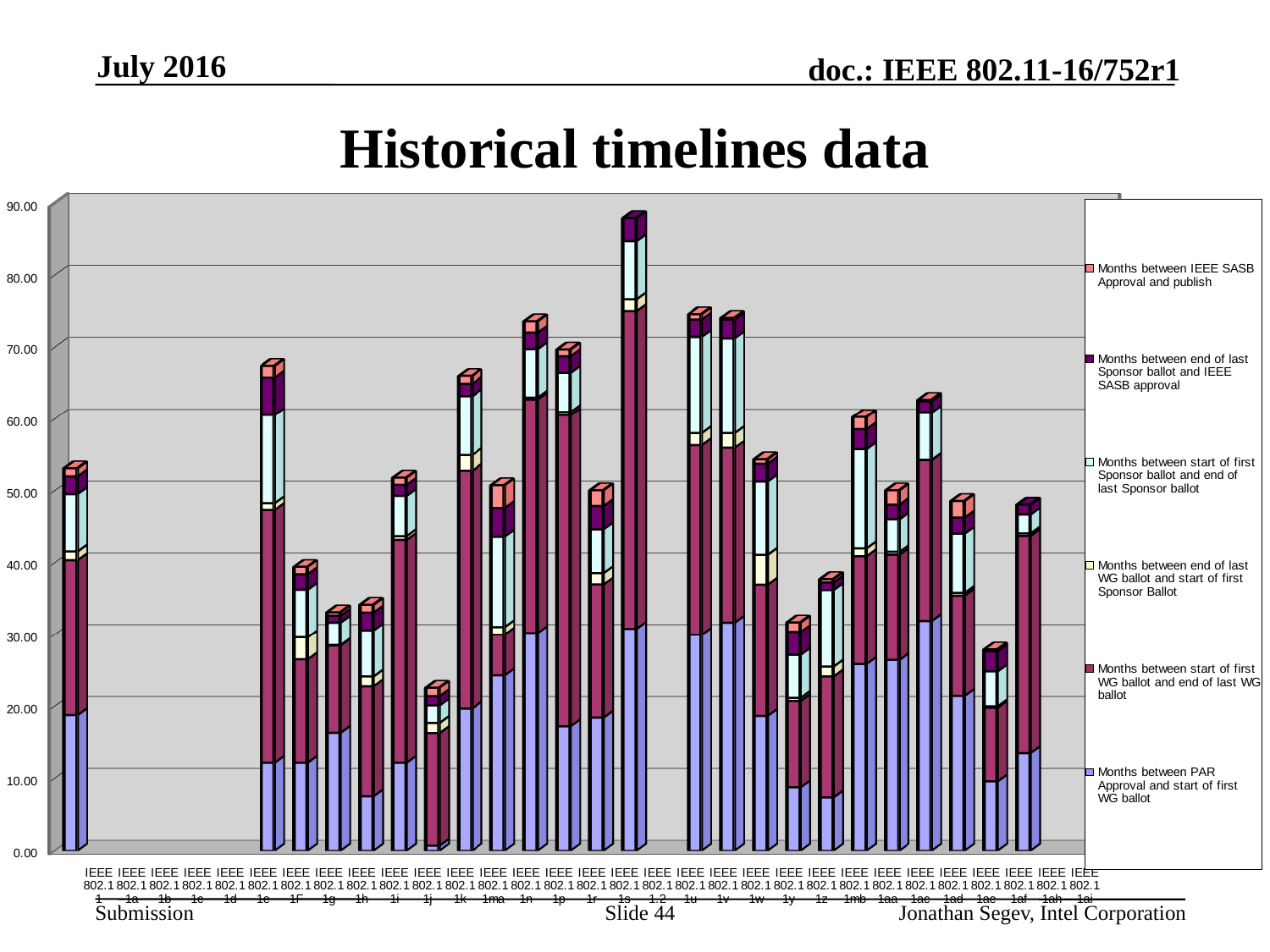
Does any stacked bar exceed 90.00 on the vertical axis? No What kind of chart is shown on the slide? Stacked bar chart Is the total of the tallest stacked bar greater or less than 80? greater What is the title of the chart? Historical timelines data Is the total of the shortest stacked bar greater or less than 30? less Which legend entry corresponds to the bottom segment of each stacked bar? Months between PAR Approval and start of first WG ballot How many series does the legend list? 6